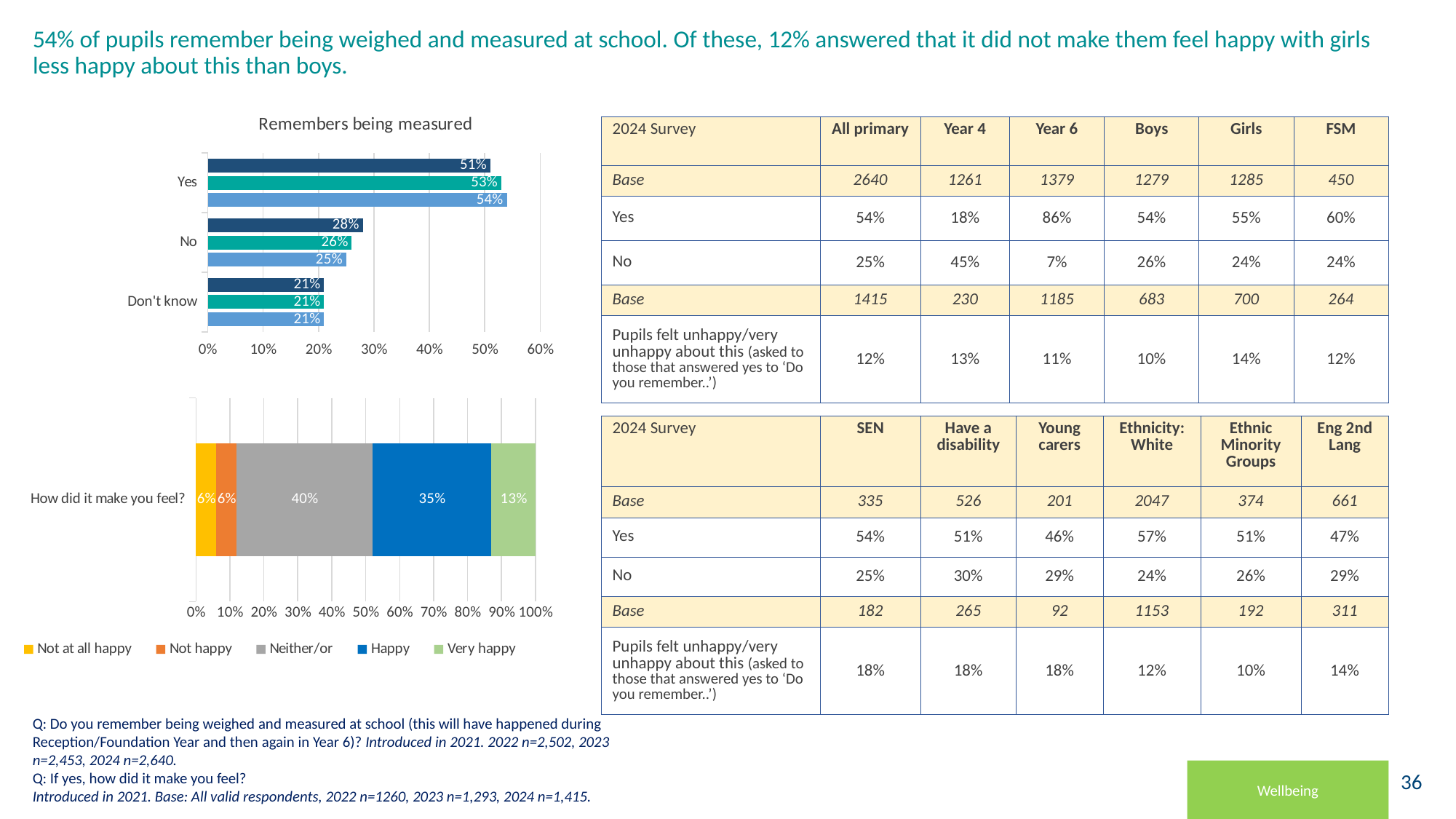
In the 'Remembers being measured' chart, what value does the bottom (light blue) bar show for 'Yes'? 54% In the 'Remembers being measured' chart, what is the difference between the light blue bar for 'Yes' (54%) and the dark blue bar for 'Yes' (51%)? 3% In the 'Remembers being measured' chart, which category has the highest values? Yes What type of chart is the 'Remembers being measured' chart? Bar chart In the 'How did it make you feel?' chart, which is larger: 'Very happy' or 'Not happy'? Very happy In the 'Remembers being measured' chart, what value does the top (dark blue) bar show for 'No'? 28% In the 'Remembers being measured' chart, which category has the lowest values? Don't know How many categories are shown on the y axis of the 'Remembers being measured' chart? 3 In the 'How did it make you feel?' chart, what percentage is shown for 'Happy'? 35% How many series does the legend of the 'How did it make you feel?' chart list? 5 In the 'Remembers being measured' chart, what value do all three bars show for 'Don't know'? 21% In the 'How did it make you feel?' chart, what percentage is shown for 'Neither/or'? 40%